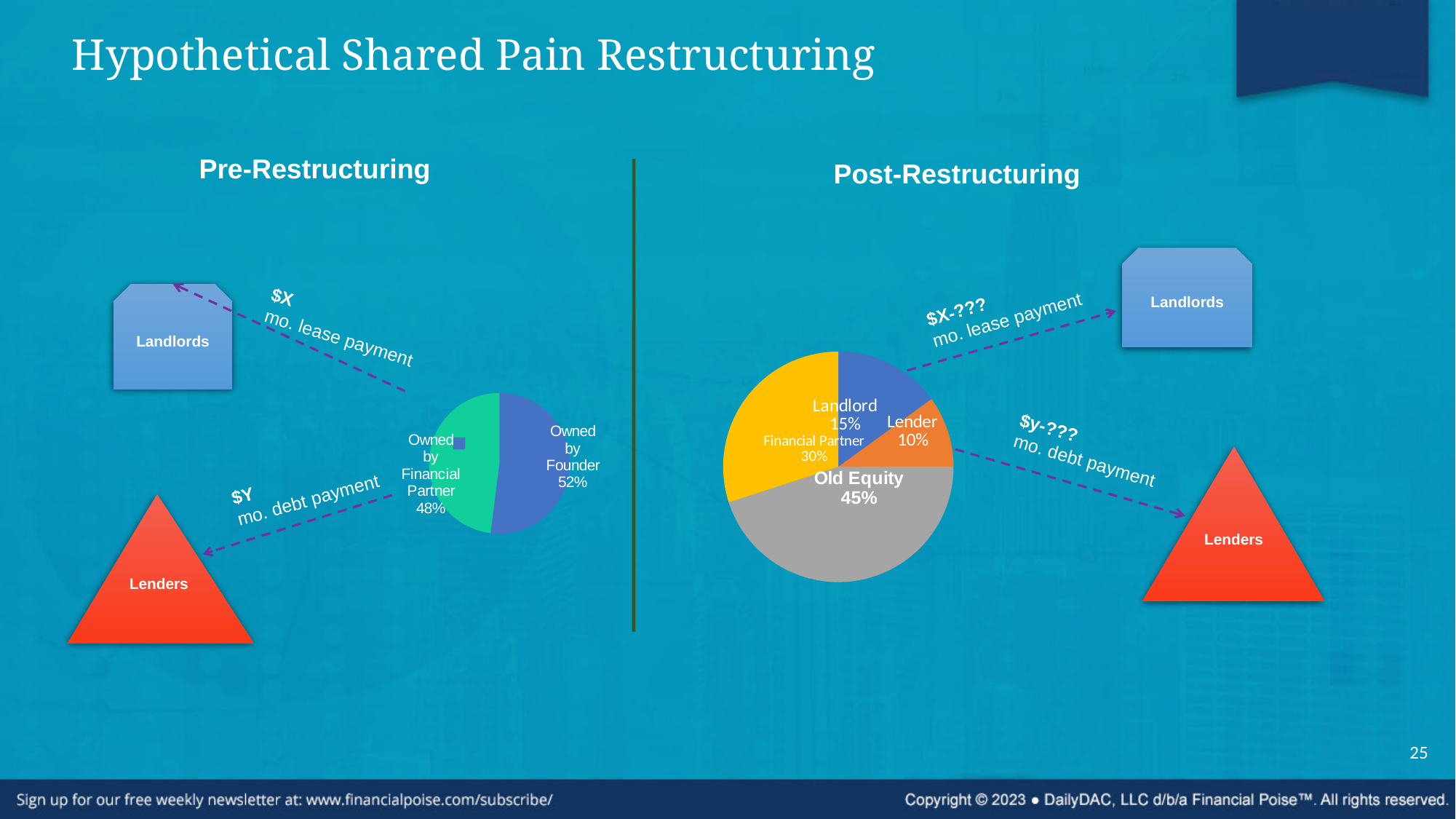
What kind of chart is shown under Pre-Restructuring? Pie chart In the Post-Restructuring pie chart, what share does the Landlord hold? 15% In the Post-Restructuring pie chart, what is the difference between the Financial Partner share and the Landlord share? 15% In the Post-Restructuring pie chart, what share does the Lender hold? 10% In the Pre-Restructuring pie chart, which slice is larger, Founder or Financial Partner? Founder In the Post-Restructuring pie chart, what share does Old Equity hold? 45% In the Post-Restructuring pie chart, which slice is the smallest? Lender How many slices does the Post-Restructuring pie chart have? 4 In the Post-Restructuring pie chart, which slice is the largest? Old Equity How many slices does the Pre-Restructuring pie chart have? 2